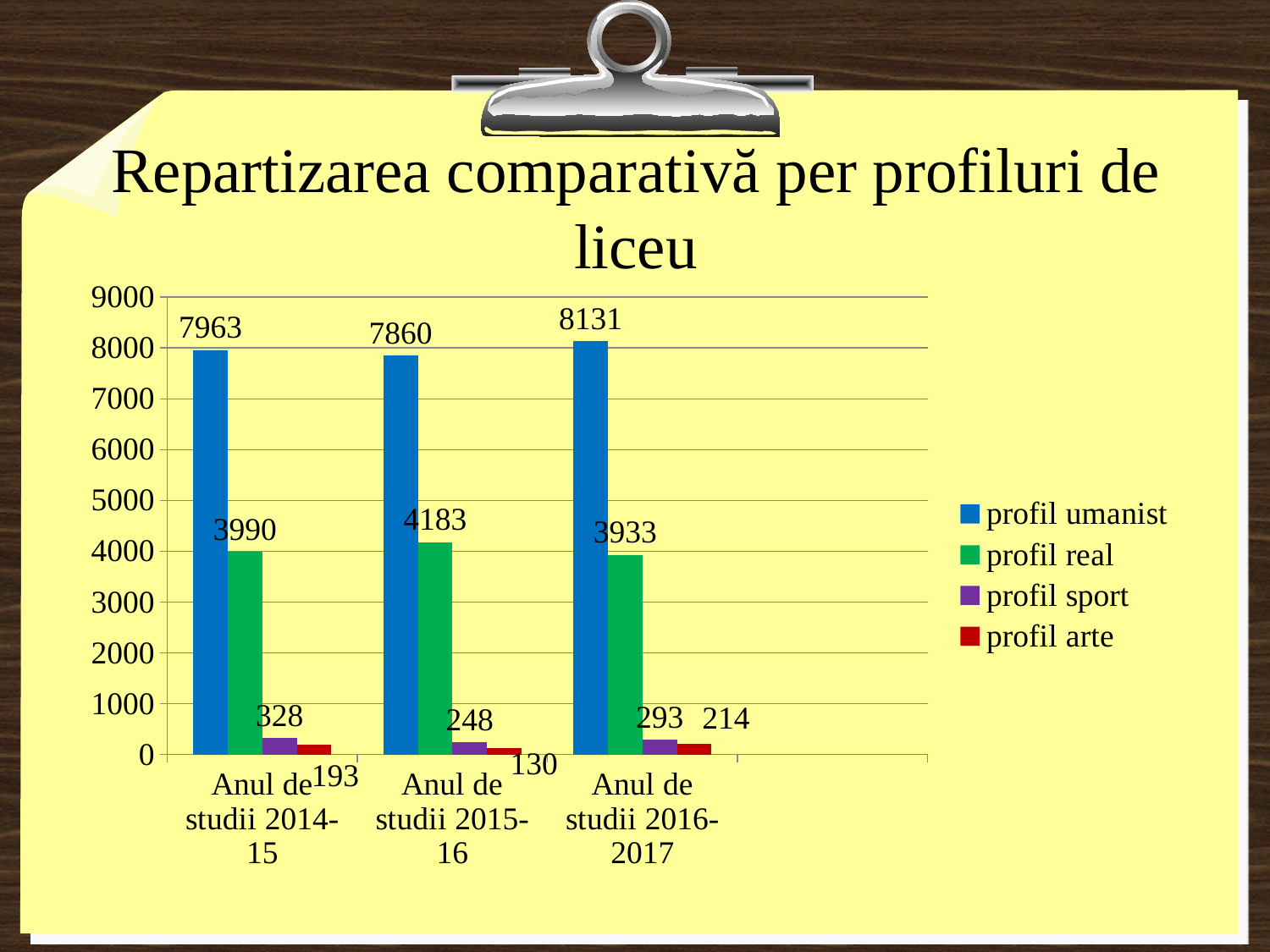
How many series does the legend list? 4 What is the value for profil arte in Anul de studii 2015-16? 130 What is the value for profil real in Anul de studii 2015-16? 4183 What is the value for profil sport in Anul de studii 2014-15? 328 What is the difference between the profil umanist values for Anul de studii 2016-2017 and Anul de studii 2015-16? 271 In which school year is the profil umanist value highest? Anul de studii 2016-2017 Which colour represents profil real in the legend? Green In which school year is the profil arte value lowest? Anul de studii 2015-16 Which is larger: profil real in Anul de studii 2014-15 or profil real in Anul de studii 2016-2017? Anul de studii 2014-15 How many school years (categories) are shown on the x axis? 3 What kind of chart is shown on the slide? Bar chart What is the value for profil umanist in Anul de studii 2016-2017? 8131